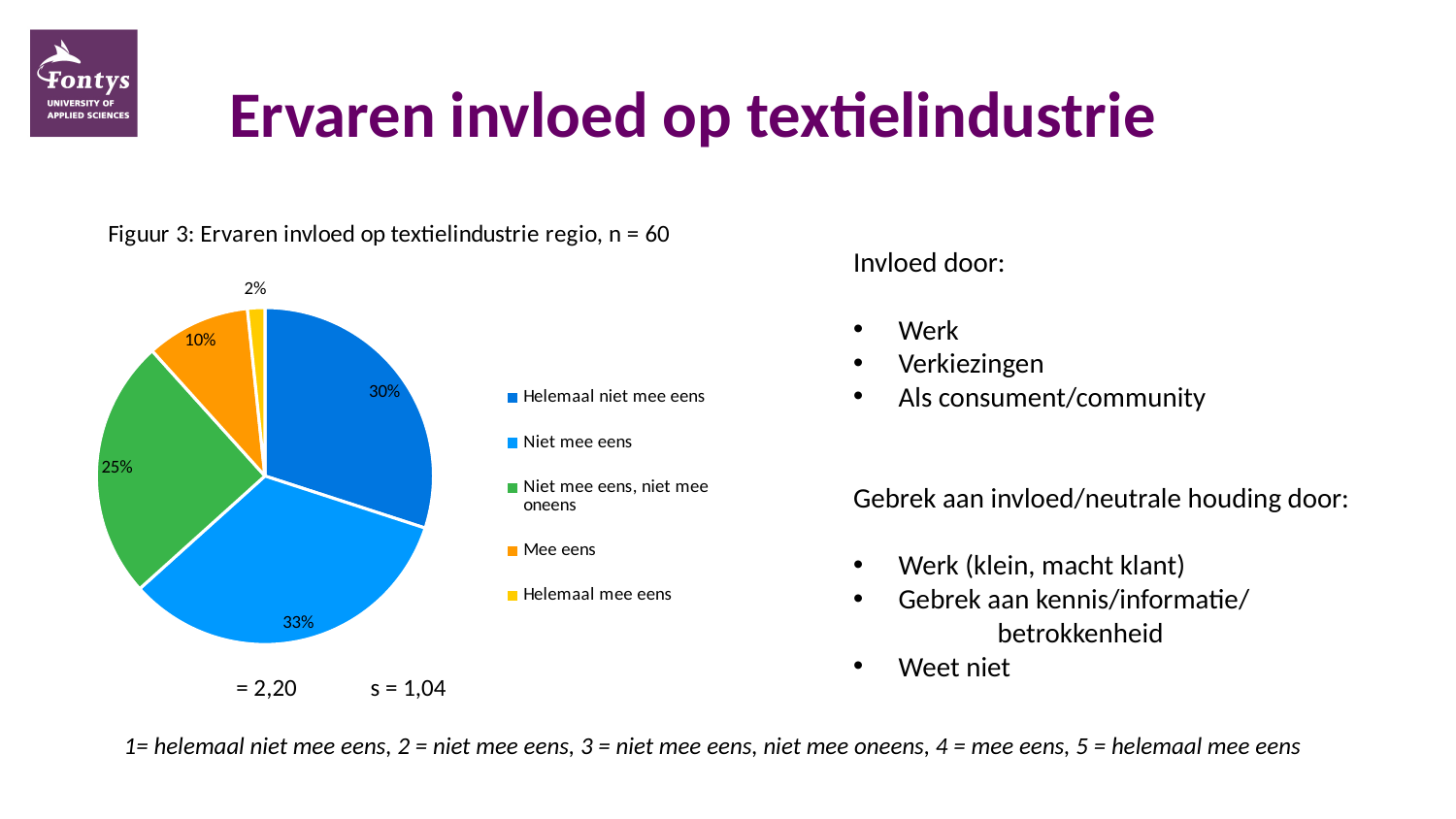
How many categories does the legend of the pie chart list? 5 Which category has the largest slice of the pie? Niet mee eens Which is larger: the slice for 'Niet mee eens, niet mee oneens' or the slice for 'Mee eens'? Niet mee eens, niet mee oneens What kind of chart is shown on the slide? pie chart What share of the pie is labelled 'Helemaal mee eens'? 2% What share of the pie is labelled 'Helemaal niet mee eens'? 30% What share of the pie is labelled 'Niet mee eens, niet mee oneens'? 25% What is the sample size (n) stated in the figure caption? 60 What is the difference in percentage points between 'Niet mee eens' and 'Mee eens'? 23 Which category has the smallest slice of the pie? Helemaal mee eens